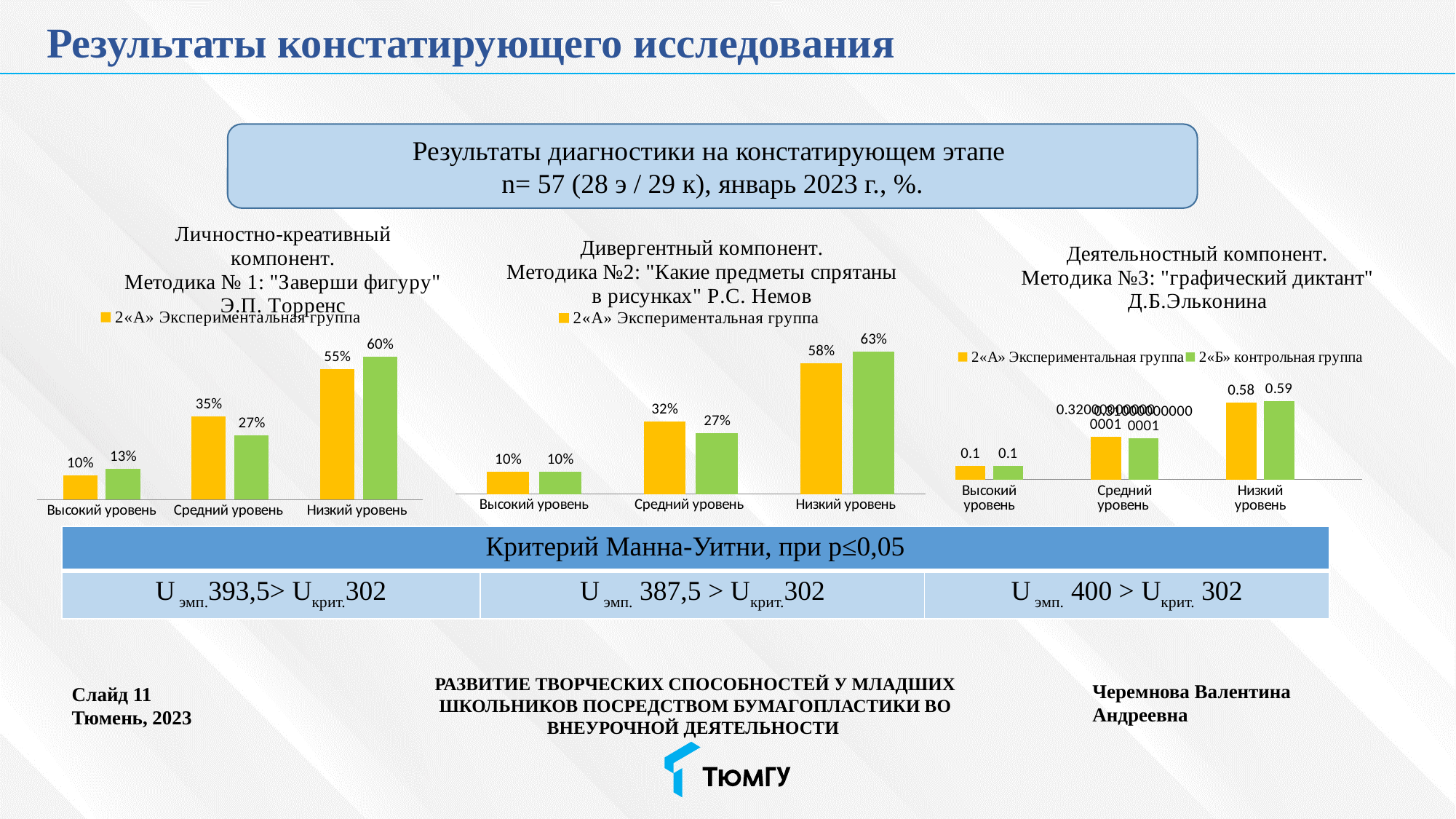
In the left chart (Личностно-креативный компонент), which level has the highest value for the 2«А» Экспериментальная группа? Низкий уровень In the right chart (Деятельностный компонент), how many series does the legend list? 2 In the middle chart (Дивергентный компонент), how many level categories are shown on the x axis? 3 In the right chart (Деятельностный компонент), what is the value for the 2«А» Экспериментальная группа at Высокий уровень? 0.1 In the middle chart (Дивергентный компонент), which is larger at Низкий уровень: the yellow bar or the green bar? the green bar In the middle chart (Дивергентный компонент), what is the value for the 2«А» Экспериментальная группа at Средний уровень? 32% In the right chart (Деятельностный компонент), what is the value for the 2«Б» контрольная группа at Низкий уровень? 0.59 In the left chart (Личностно-креативный компонент), what is the value for the 2«А» Экспериментальная группа at Низкий уровень? 55% What type of chart is the left chart (Личностно-креативный компонент)? bar chart In the left chart (Личностно-креативный компонент), what is the value of the green bar at Средний уровень? 27% In the middle chart (Дивергентный компонент), what is the value of the green bar at Низкий уровень? 63% In the left chart (Личностно-креативный компонент), what is the difference between the two bars at Высокий уровень? 3%